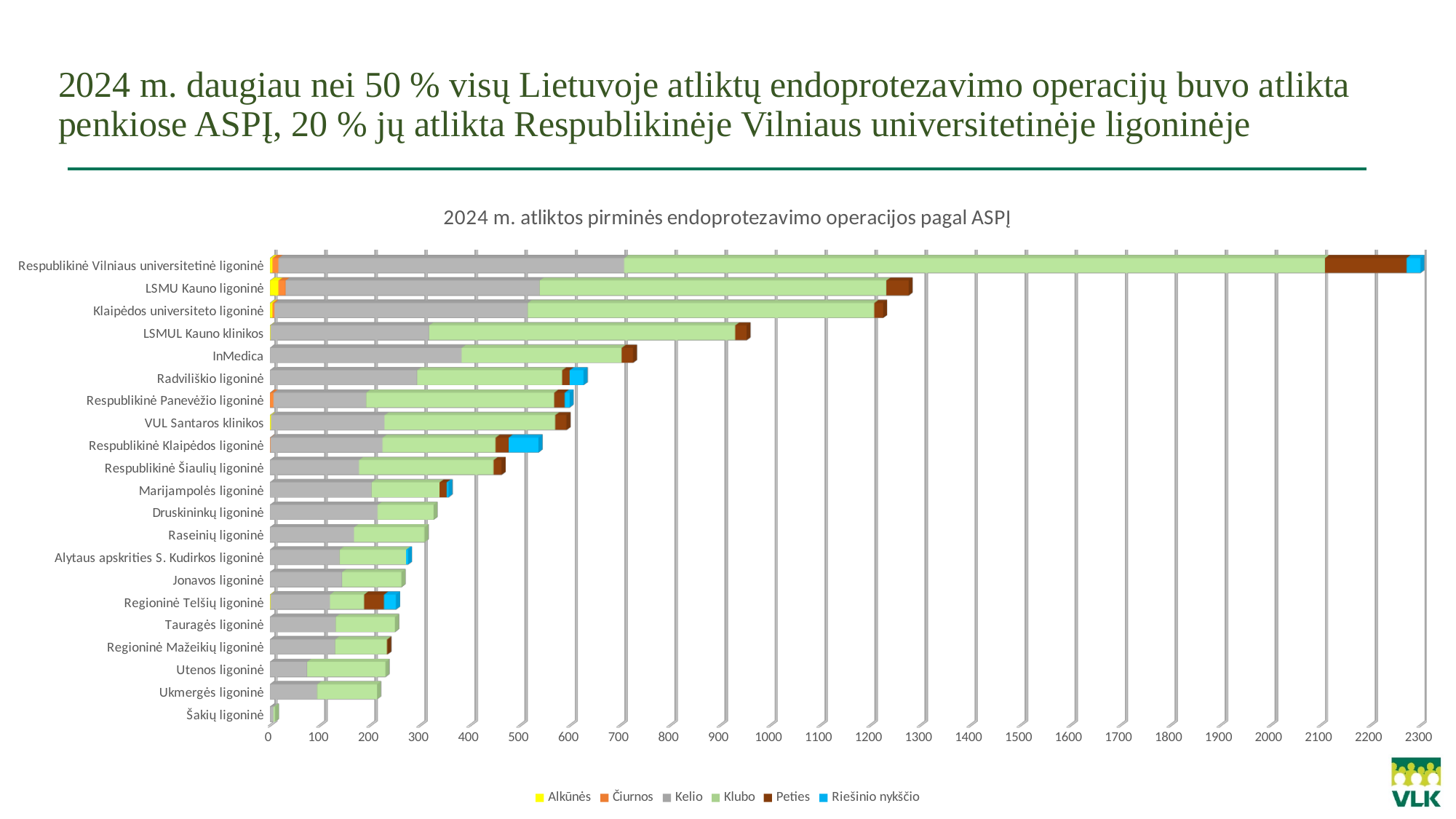
What is the title of the chart? 2024 m. atliktos pirminės endoprotezavimo operacijos pagal ASPĮ Which hospital has the lowest total number of operations? Šakių ligoninė Which hospital has the highest total number of operations? Respublikinė Vilniaus universitetinė ligoninė Which has a larger total, Respublikinė Klaipėdos ligoninė or Respublikinė Šiaulių ligoninė? Respublikinė Klaipėdos ligoninė Is the total value for LSMU Kauno ligoninė greater or less than 1200? greater Is the total value for Respublikinė Vilniaus universitetinė ligoninė greater or less than 2000? greater Is the total value for Šakių ligoninė greater or less than 100? less How many series does the legend list? 6 Which has a larger total, InMedica or Radviliškio ligoninė? InMedica How many hospitals (categories) are shown in the chart? 21 What kind of chart is shown on the slide? Stacked bar chart